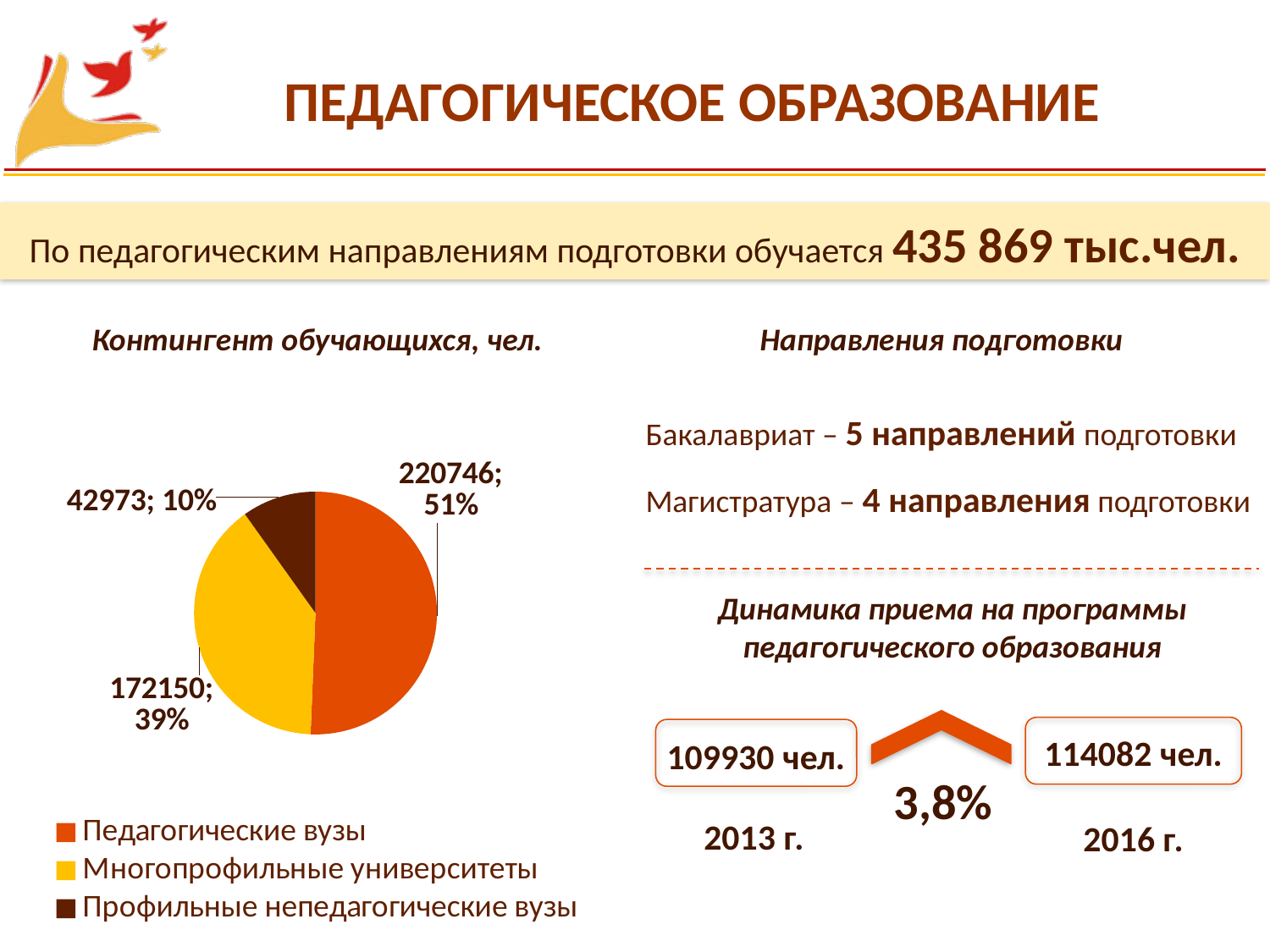
What is the value for "Многопрофильные университеты" in the pie chart? 172150 How many entries does the legend of the pie chart list? 3 Which category has the largest slice in the pie chart? Педагогические вузы What share of the pie does "Педагогические вузы" take? 51% Which colour represents "Многопрофильные университеты" in the pie chart? yellow Which category has the smallest slice in the pie chart? Профильные непедагогические вузы What is the value for "Педагогические вузы" in the pie chart? 220746 How many slices does the pie chart "Контингент обучающихся, чел." have? 3 What is the difference between the values for "Педагогические вузы" and "Многопрофильные университеты" in the pie chart? 48596 What kind of chart is shown under the title "Контингент обучающихся, чел."? pie chart What is the value for "Профильные непедагогические вузы" in the pie chart? 42973 What share of the pie does "Профильные непедагогические вузы" take? 10%